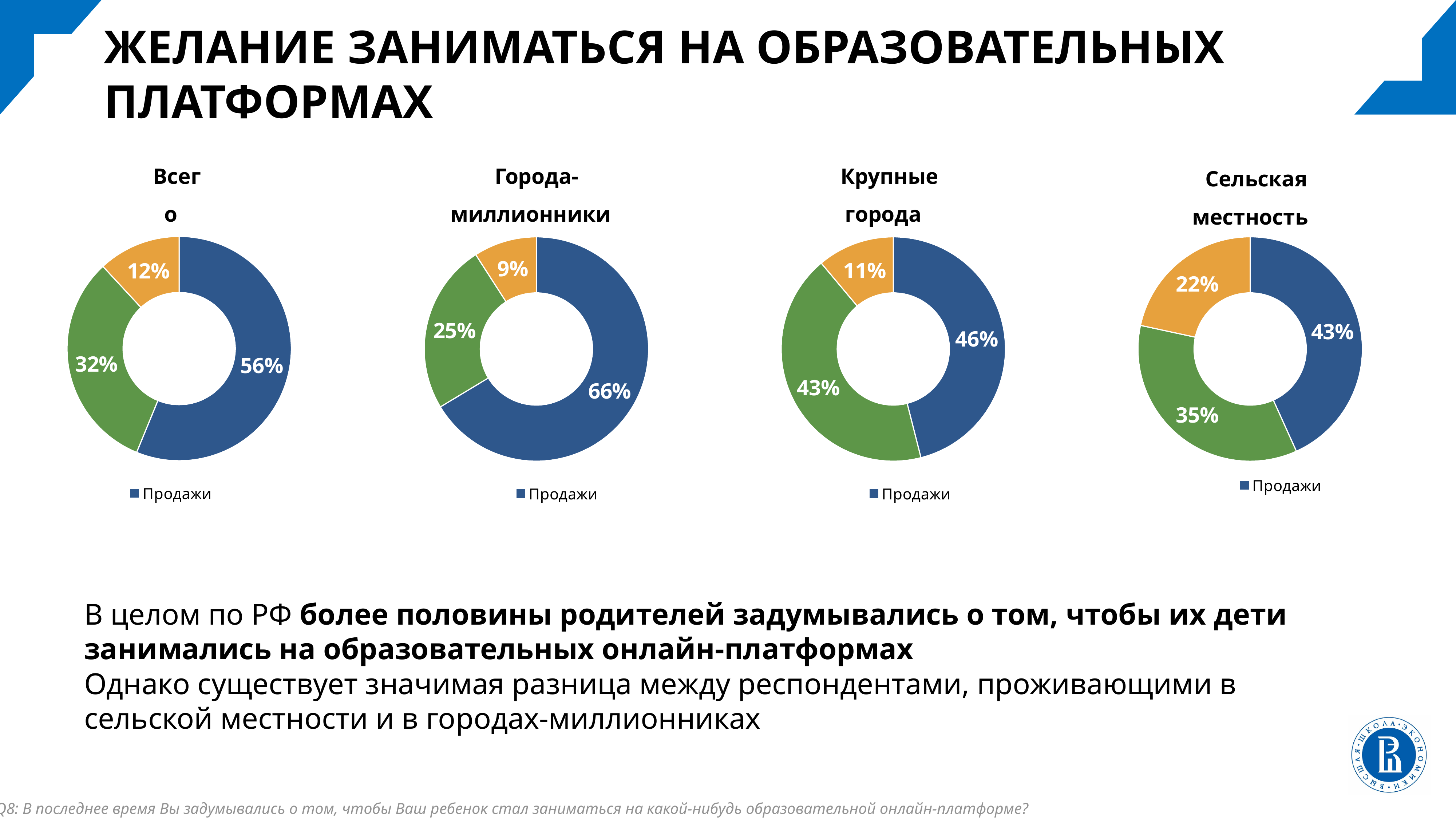
How many donut charts are shown on the slide? 4 What legend entry is shown under each chart? Продажи In the 'Города-миллионники' chart, what value is shown on the blue slice? 66% In the 'Сельская местность' chart, what value is shown on the orange slice? 22% What is the difference between the blue slice in the 'Города-миллионники' chart and the blue slice in the 'Сельская местность' chart? 23 percentage points In the 'Крупные города' chart, what value is shown on the green slice? 43% How many slices does the 'Крупные города' chart have? 3 In the 'Города-миллионники' chart, which slice is the smallest? the orange slice (9%) Which is larger: the orange slice in the 'Всего' chart or the orange slice in the 'Крупные города' chart? the orange slice in the 'Всего' chart (12%) In the 'Сельская местность' chart, which slice is the largest? the blue slice (43%) What type of chart is used on this slide? donut (pie) chart In the 'Всего' chart, what value is shown on the blue slice? 56%